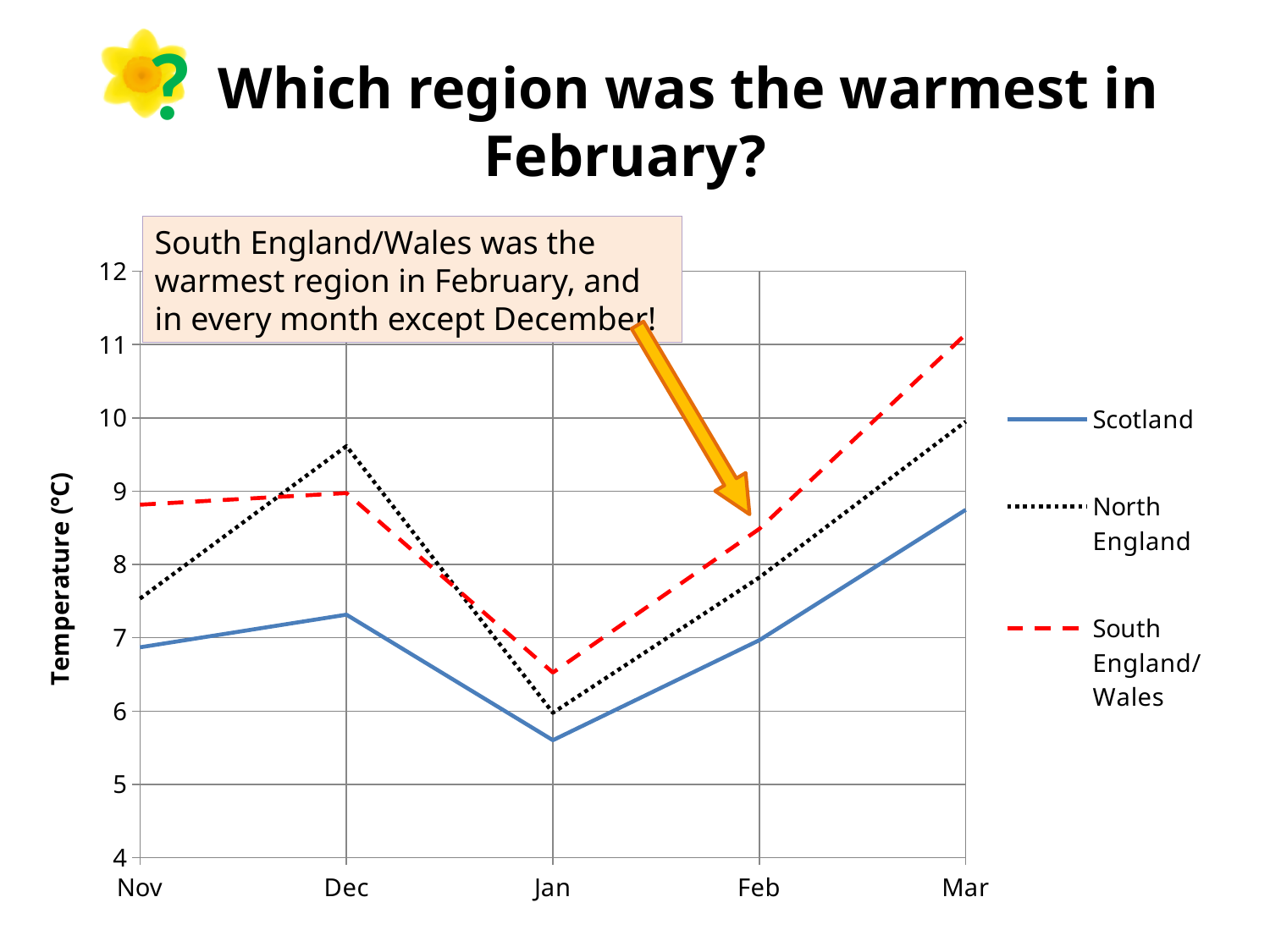
How many series does the legend list? 3 How many months are plotted along the x axis? 5 Do the values for Scotland rise or fall from Jan to Mar? rise Is the value for South England/Wales in Mar greater or less than 10? greater What kind of chart is shown on the slide? line chart In Mar, which is larger: the value for Scotland or the value for North England? North England Is the value for Scotland in Jan greater or less than 6? less Which region has the highest temperature in Dec? North England Is the value for North England in Nov greater or less than 8? less Which region has the highest temperature in Feb? South England/Wales Which region has the lowest temperature in Jan? Scotland In which month is the temperature for South England/Wales lowest? Jan